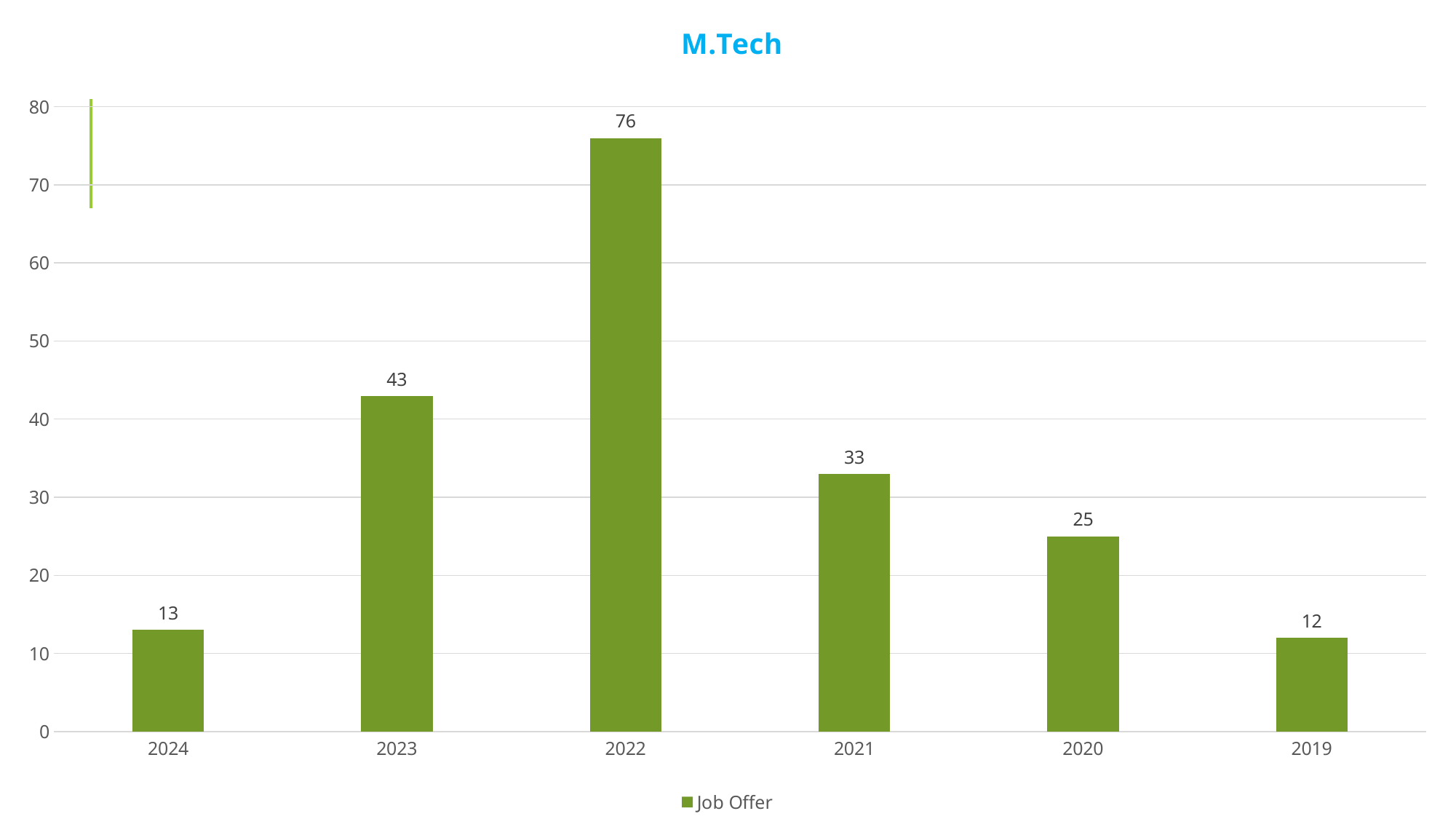
How many series does the legend list? 1 Which year has a larger Job Offer value, 2021 or 2020? 2021 What is the Job Offer value for 2022? 76 What is the Job Offer value for 2024? 13 How many years are shown on the x axis? 6 Which year has the lowest Job Offer value? 2019 Is the value for 2023 greater or less than 40? greater What is the difference between the Job Offer values for 2022 and 2023? 33 What is the Job Offer value for 2020? 25 What is the title of the chart? M.Tech What kind of chart is shown on the slide? bar chart Which year has the highest Job Offer value? 2022